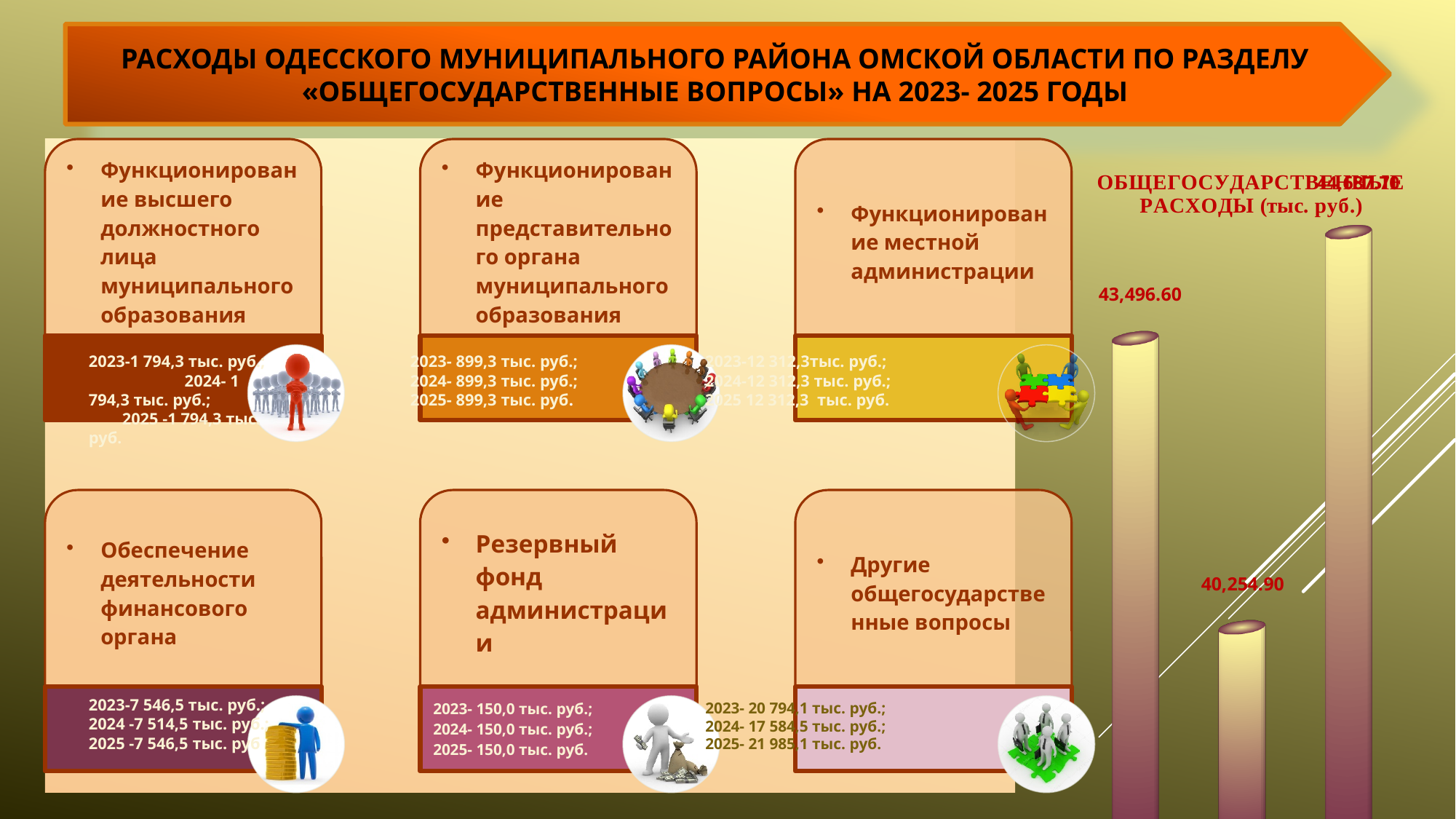
In the chart on the right, which bar is the lowest: the leftmost, middle or rightmost? middle In the chart on the right, which bar is the highest: the leftmost, middle or rightmost? rightmost What kind of chart is shown on the right side of the slide? bar chart In the chart on the right, what value is labelled on the middle bar? 40,254.90 How many bars does the chart on the right side of the slide contain? 3 In the chart on the right, which is larger: the leftmost bar or the middle bar? leftmost bar What is the title of the chart on the right side of the slide? ОБЩЕГОСУДАРСТВЕННЫЕ РАСХОДЫ (тыс. руб.) In the chart on the right, what value is labelled on the leftmost bar? 43,496.60 In the chart on the right, what is the difference between the leftmost bar (43,496.60) and the middle bar (40,254.90)? 3,241.70 What unit is given in the title of the chart on the right? тыс. руб. In the chart on the right, does the value rise or fall from the leftmost bar to the middle bar? fall In the chart on the right, does the value rise or fall from the middle bar to the rightmost bar? rise